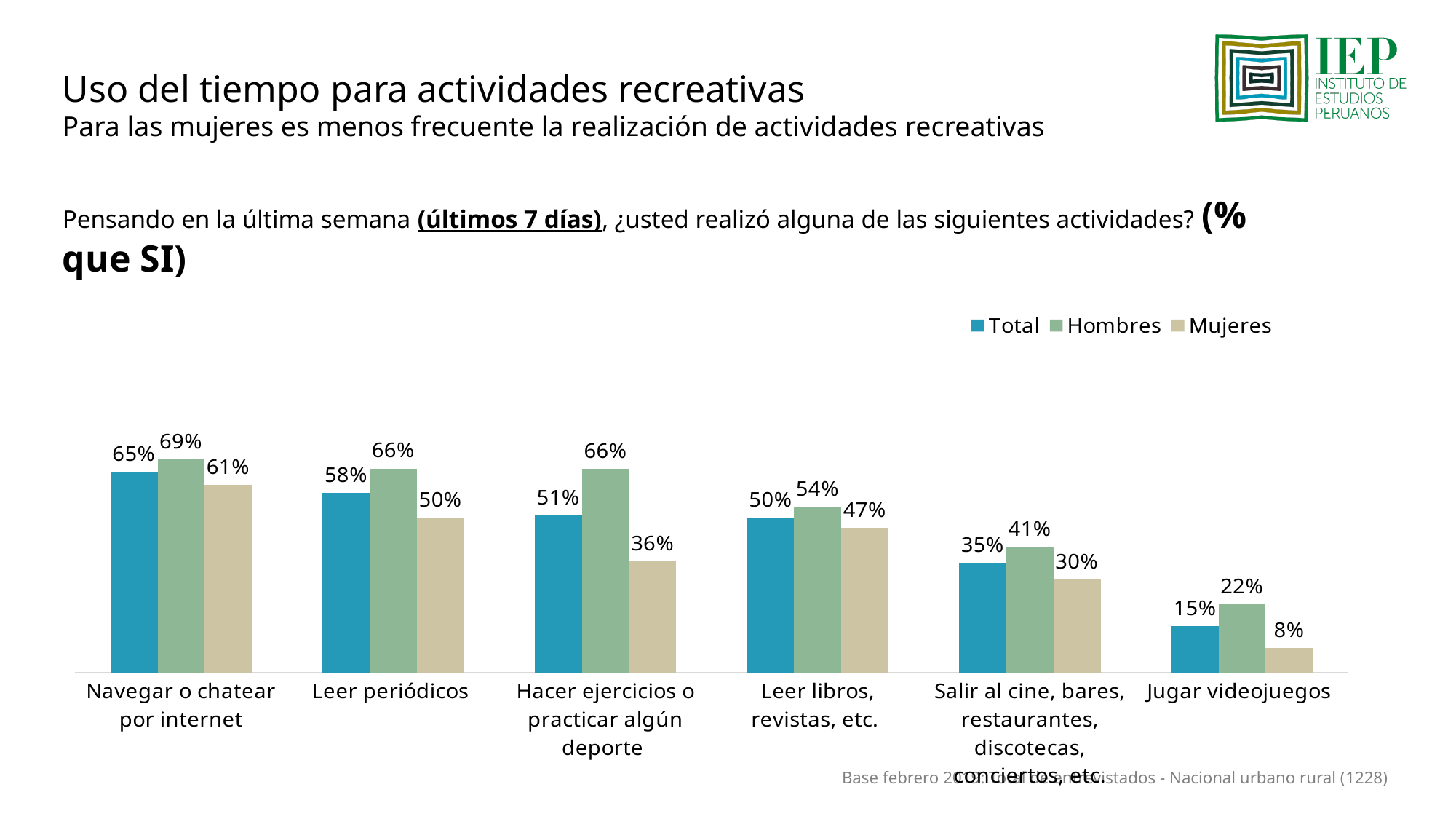
Which series is shown in the tan/beige colour in the legend? Mujeres Which is larger for "Salir al cine, bares, restaurantes, discotecas, conciertos, etc.": the Hombres value or the Mujeres value? Hombres Do the Total values rise or fall from left to right across the categories? Fall Which category has the highest Hombres value? Navegar o chatear por internet What is the Hombres value for "Jugar videojuegos"? 22% Which category has the lowest Mujeres value? Jugar videojuegos What is the Total value for "Leer periódicos"? 58% What is the Mujeres value for "Hacer ejercicios o practicar algún deporte"? 36% What is the difference between the Hombres and Mujeres values for "Hacer ejercicios o practicar algún deporte"? 30% How many series does the legend list? 3 What kind of chart is shown on the slide? Bar chart How many activity categories are shown on the x axis? 6